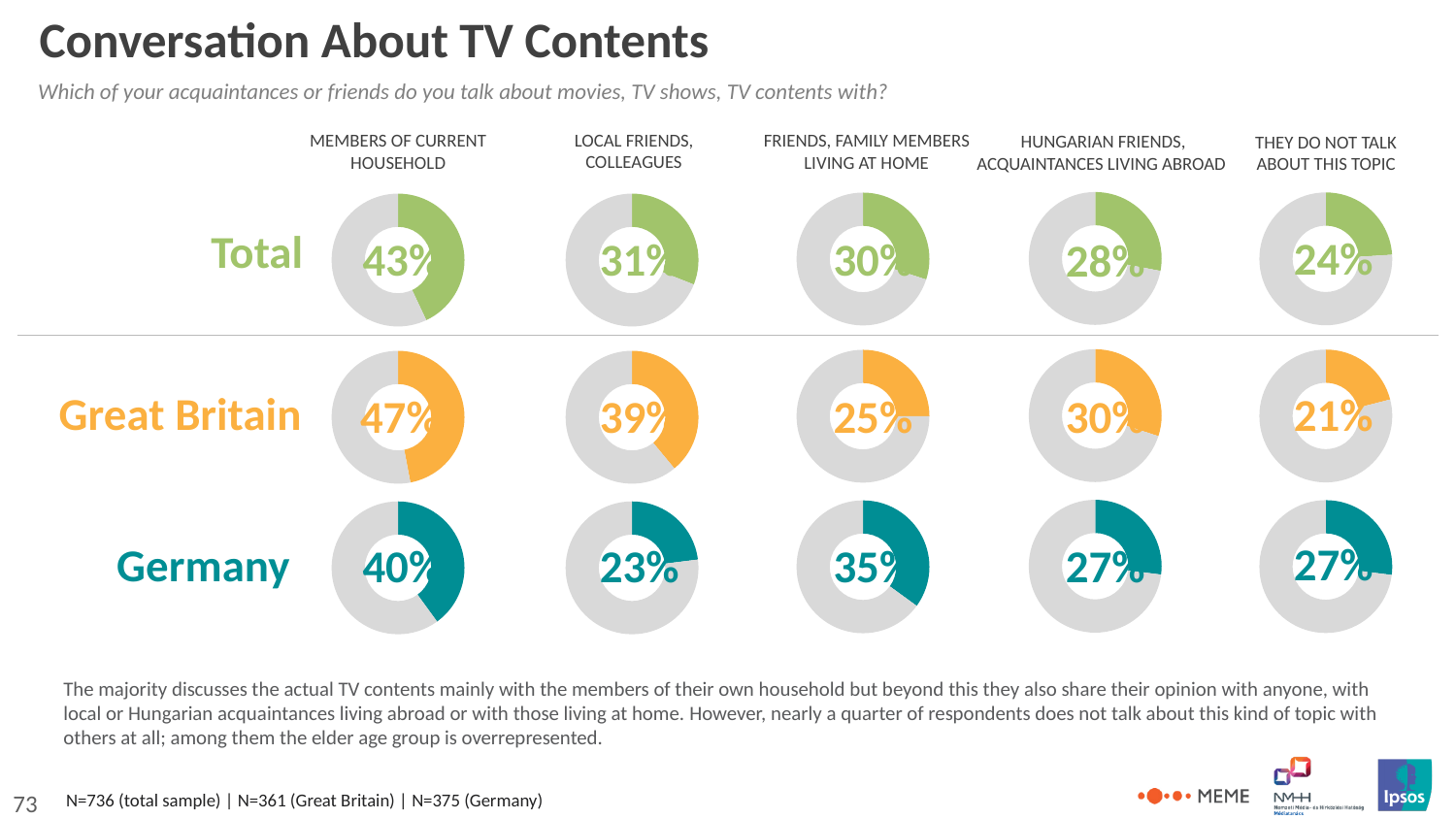
What percentage of the Total sample talks about TV contents with members of their current household? 43% In the Total row, which category has the highest value? Members of current household What share of Great Britain respondents do not talk about this topic? 21% In the Germany row, what is the value for friends, family members living at home? 35% In the Germany row, which category has the lowest value? Local friends, colleagues What kind of chart is used to show each value on this slide? Donut (pie) chart In the Total row, which category has the lowest value? They do not talk about this topic In the Great Britain row, what is the value for local friends, colleagues? 39% For local friends, colleagues, which is larger: the Great Britain value or the Germany value? Great Britain What is the difference between the Great Britain and Germany values for members of current household? 7 percentage points How many donut charts are shown in the Total row? 5 What colour are the donut charts in the Germany row? Teal